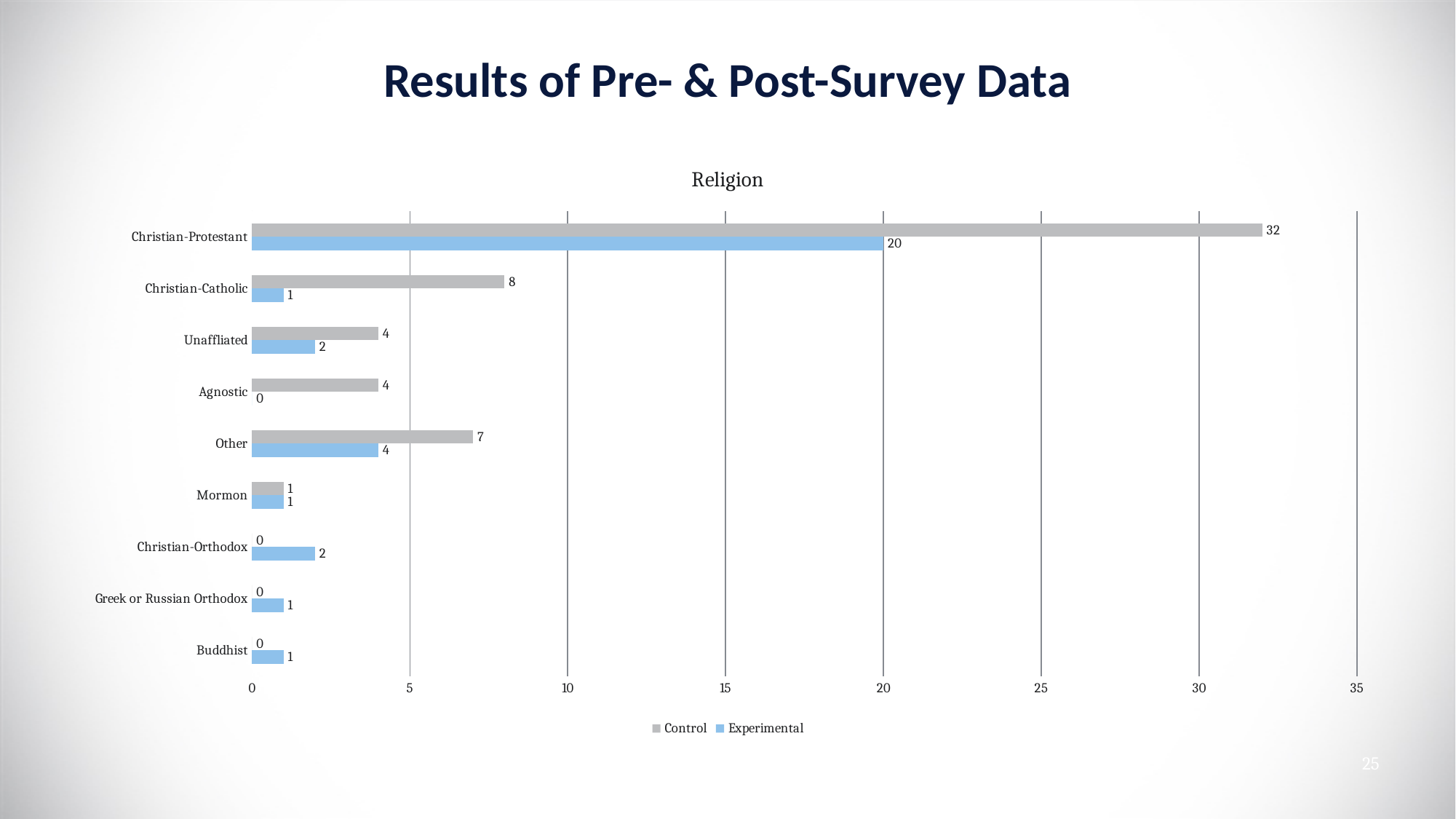
What kind of chart is shown on the slide? Bar chart Which category has the highest Experimental value? Christian-Protestant What is the Experimental value for Christian-Catholic? 1 How many religion categories are shown on the chart? 9 Which category has the highest Control value? Christian-Protestant How many series does the legend list? 2 What is the Control value for Christian-Protestant? 32 What is the difference between the Control values for Christian-Catholic and Other? 1 Which is larger for Christian-Orthodox, the Control value or the Experimental value? Experimental What is the title of the chart? Religion What is the Experimental value for Agnostic? 0 What is the difference between the Control and Experimental values for Christian-Protestant? 12